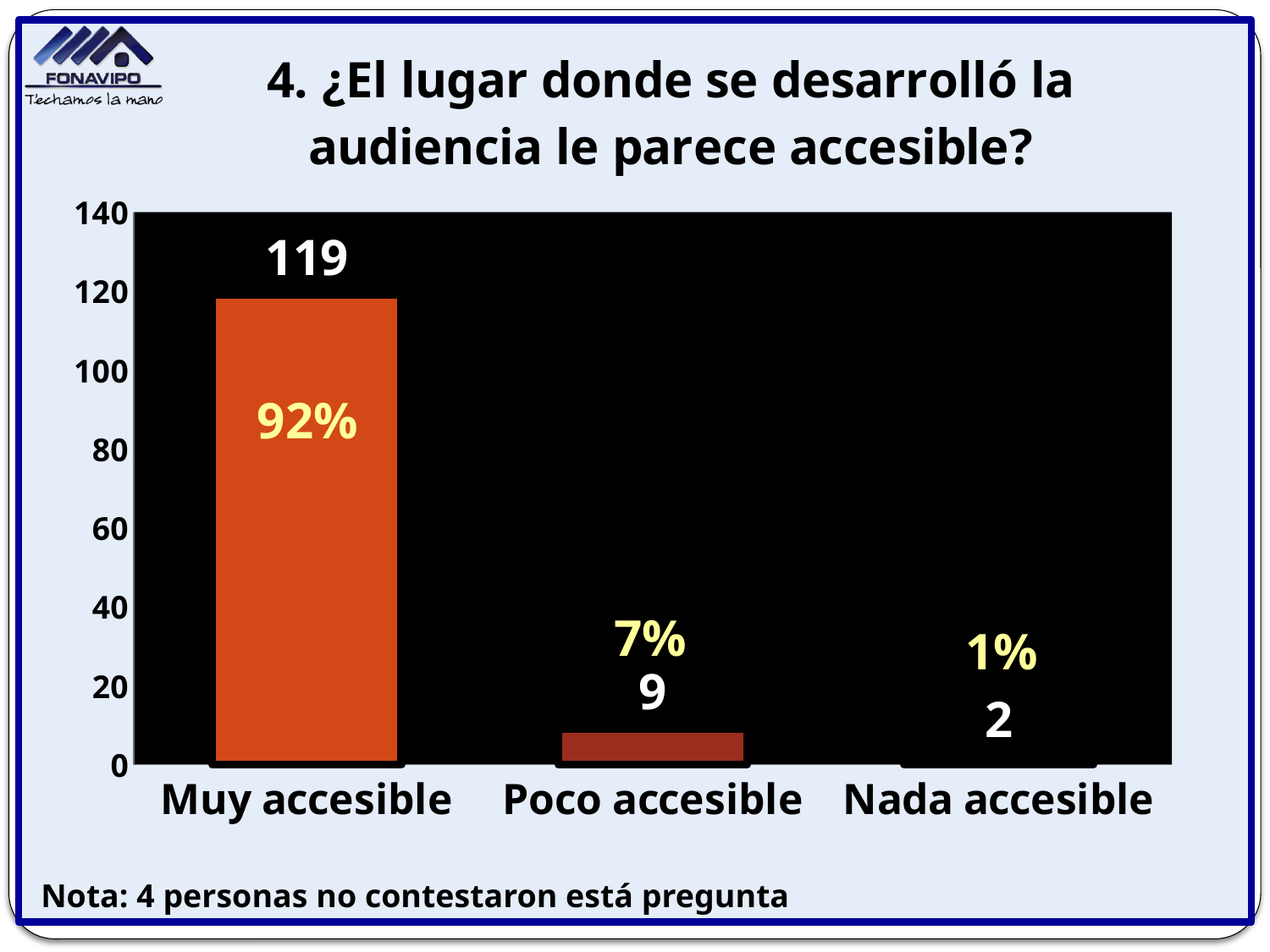
What percentage is shown for Muy accesible? 92% What percentage is shown for Poco accesible? 7% How many categories are shown on the x axis? 3 What is the value for Nada accesible? 2 What is the total of the three values shown in the chart? 130 What kind of chart is shown on the slide? Bar chart What is the difference between the values for Muy accesible and Poco accesible? 110 Which is larger, the value for Poco accesible or the value for Nada accesible? Poco accesible What is the value for Muy accesible? 119 Which category has the lowest value? Nada accesible What is the value for Poco accesible? 9 Which category has the highest value? Muy accesible